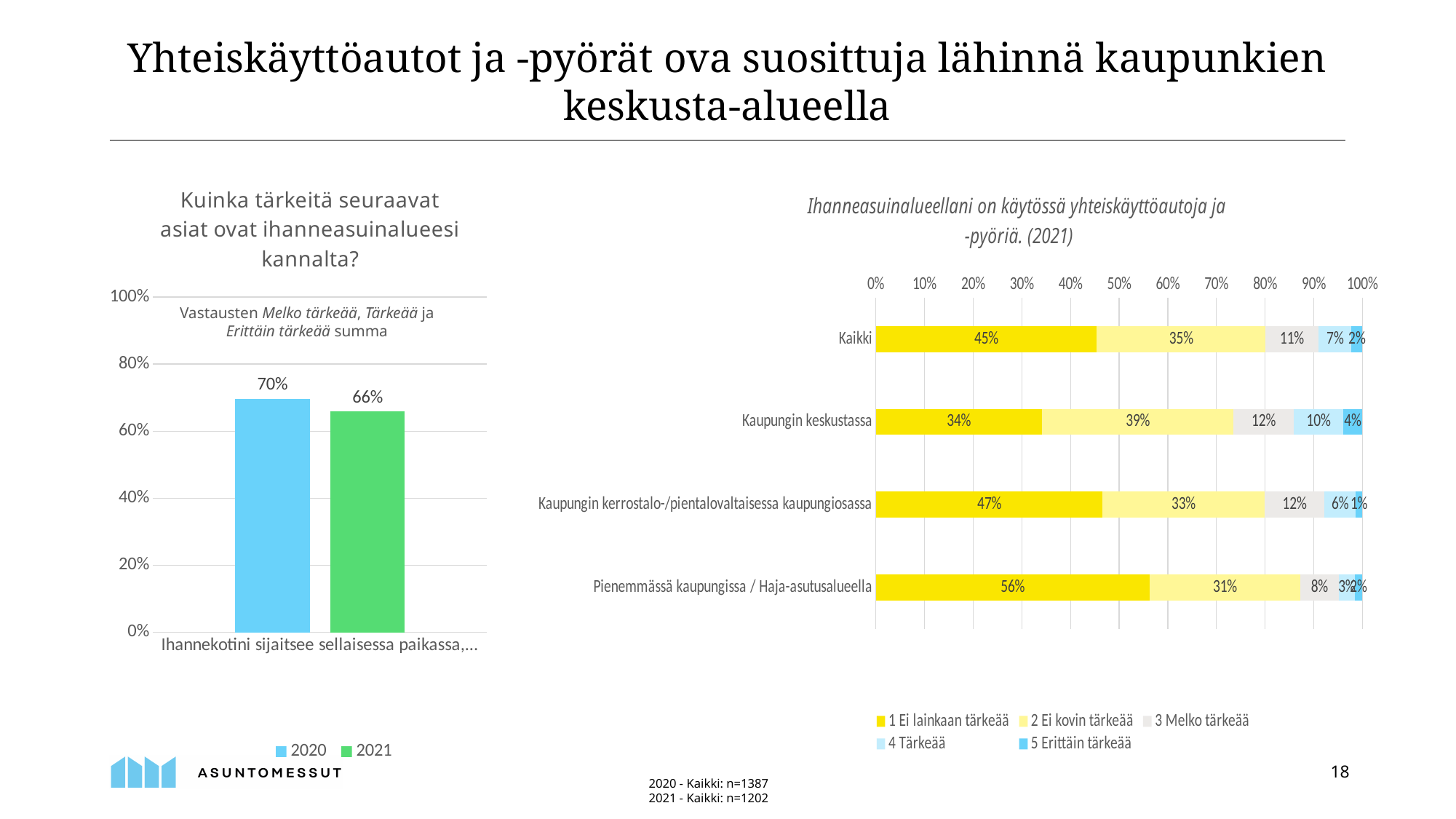
In the right chart, what share of 'Kaikki' answered '1 Ei lainkaan tärkeää'? 45% In the left chart, what is the value for 2021? 66% In the right chart, which category has the highest share for '1 Ei lainkaan tärkeää'? Pienemmässä kaupungissa / Haja-asutusalueella In the left chart, which year has the higher value, 2020 or 2021? 2020 In the right chart, what share of 'Kaupungin keskustassa' answered '4 Tärkeää'? 10% In the right chart, which category has the lowest share for '1 Ei lainkaan tärkeää'? Kaupungin keskustassa In the left chart, how many series does the legend list? 2 In the right chart, how many series does the legend list? 5 What kind of chart is the right chart? Stacked bar chart In the left chart, what is the value for 2020? 70% In the left chart, what is the difference between the 2020 and 2021 values? 4 percentage points In the right chart, how many categories are shown on the vertical axis? 4